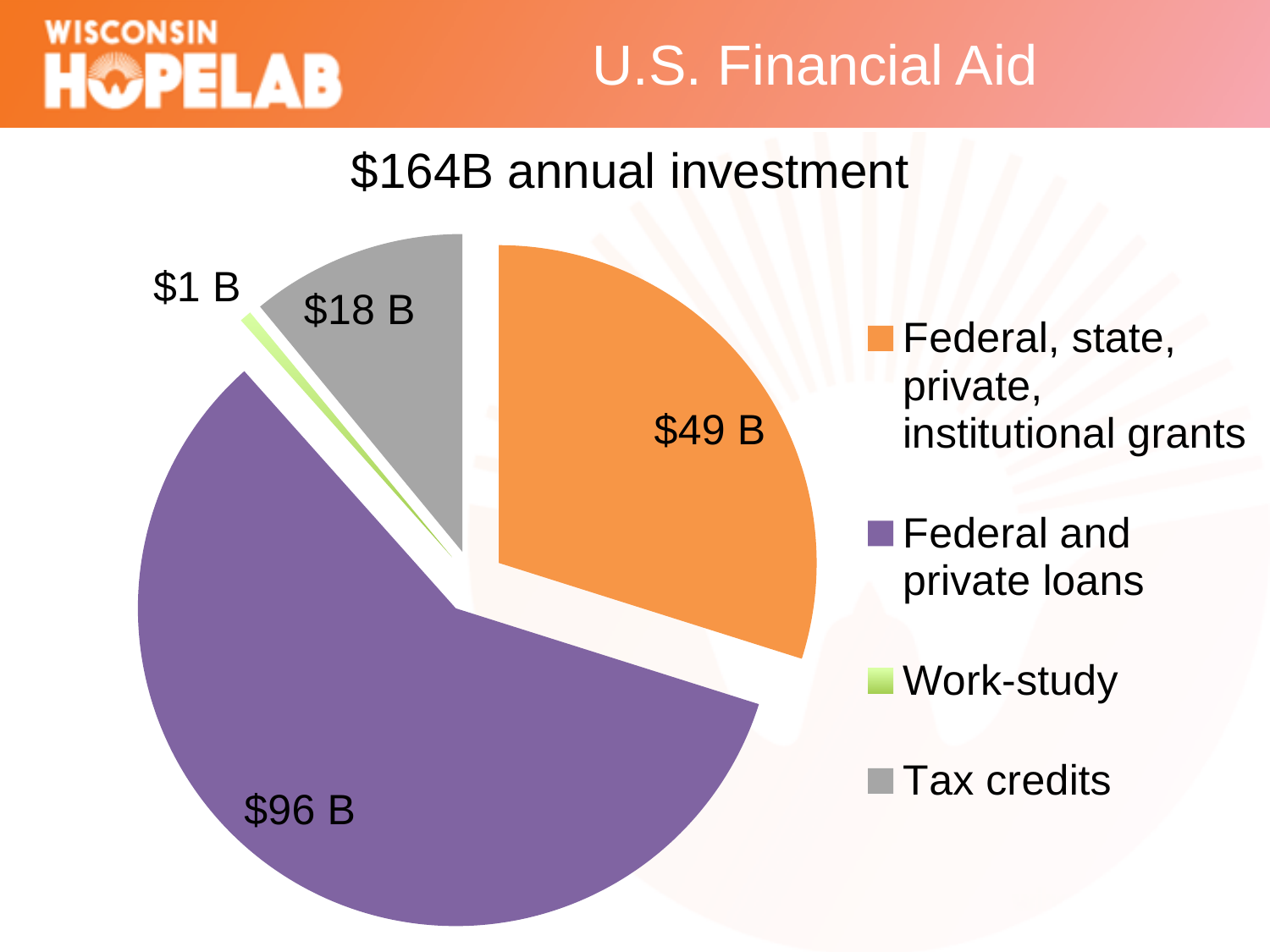
Which category has the largest slice of the pie? Federal and private loans What is the value for Federal and private loans? $96 B How many categories does the pie chart show? 4 What kind of chart is shown on the slide? Pie chart What is the value for Work-study? $1 B What is the total annual investment stated above the chart? $164B Which is larger, Tax credits or Federal, state, private, institutional grants? Federal, state, private, institutional grants What is the value for Tax credits? $18 B Which category has the smallest slice of the pie? Work-study What is the value for Federal, state, private, institutional grants? $49 B What is the difference between Tax credits and Work-study? $17 B What is the difference between Federal and private loans and Federal, state, private, institutional grants? $47 B